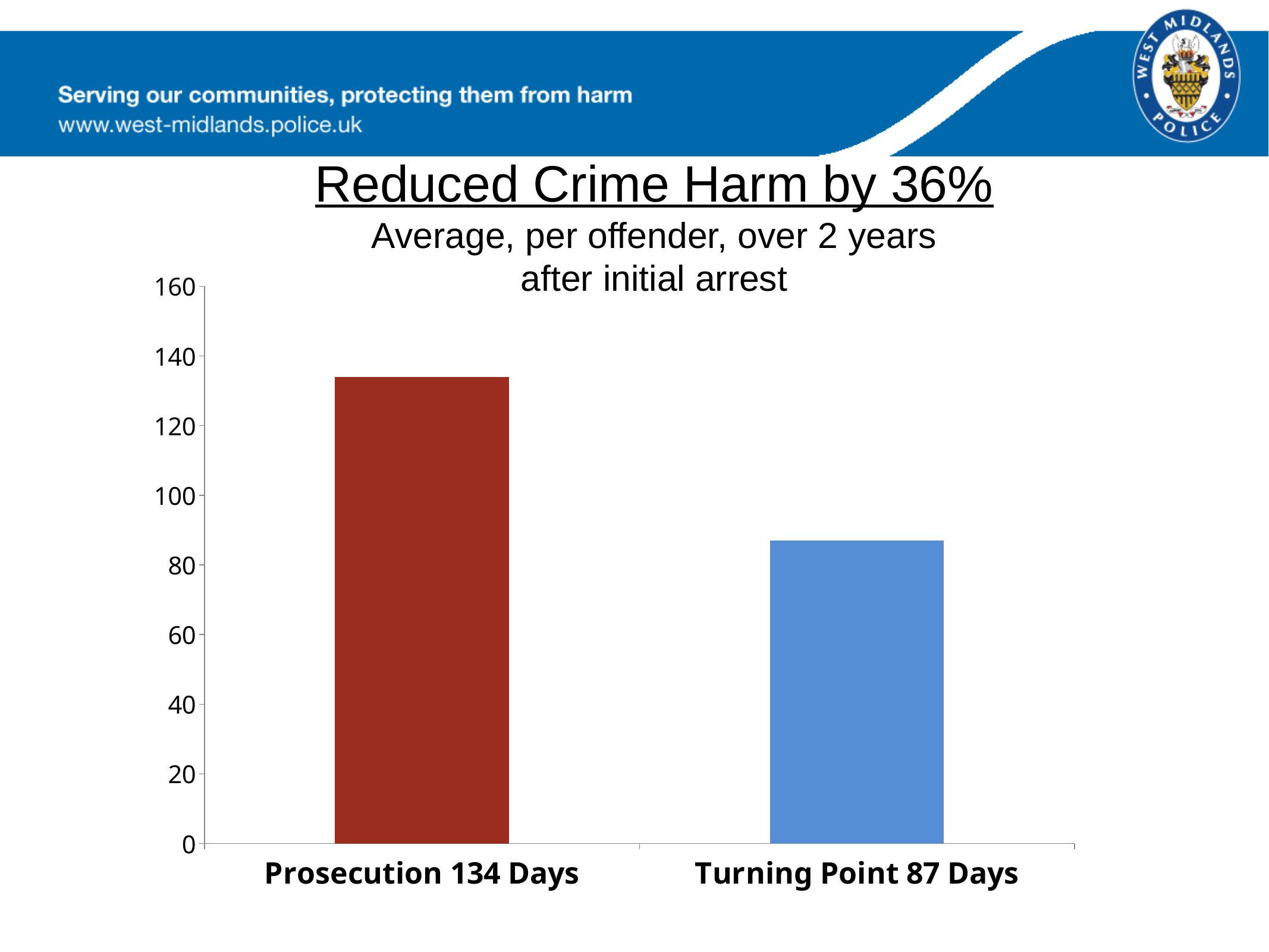
How many bars does the chart show? 2 What is the difference in days between Prosecution and Turning Point? 47 Days What kind of chart is shown on the slide? bar chart What colour is the Turning Point bar? blue Is the value for Turning Point greater or less than 100? less Is the value for Prosecution greater or less than 120? greater What is the value for Turning Point, in days? 87 Days Which is larger, the value for Prosecution or the value for Turning Point? Prosecution Which category has the highest bar? Prosecution 134 Days What is the value for Prosecution, in days? 134 Days What is the title of the chart? Reduced Crime Harm by 36% Which category has the lowest bar? Turning Point 87 Days